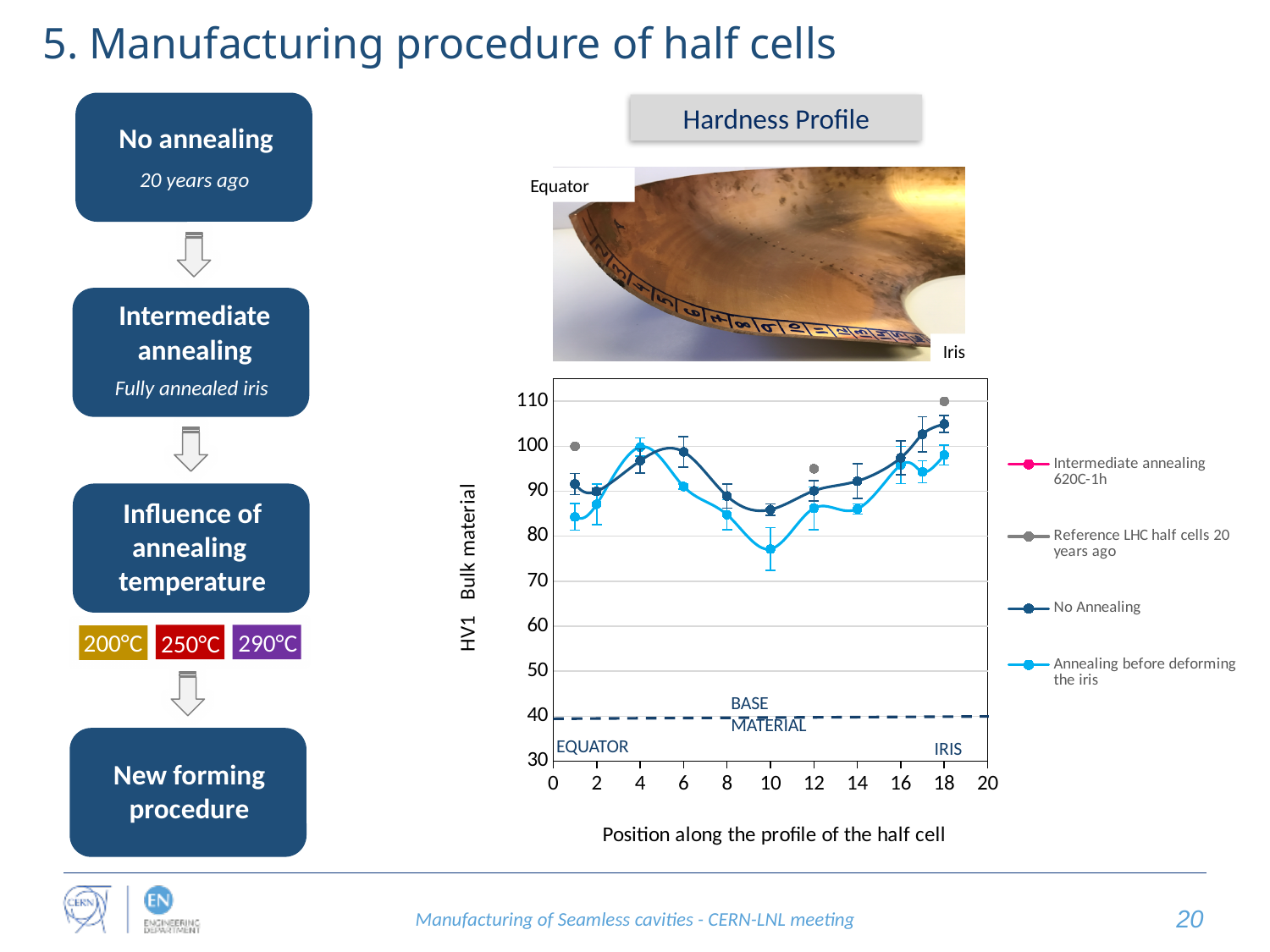
Does the 'No Annealing' series rise or fall between position 12 and position 18? rise At which position does the 'Annealing before deforming the iris' series reach its lowest value? 10 What is the title shown above the chart area? Hardness Profile At position 18, which series has the higher value: 'Reference LHC half cells 20 years ago' or 'No Annealing'? Reference LHC half cells 20 years ago Is the value of the 'Reference LHC half cells 20 years ago' series at position 12 greater or less than 90? greater How many series does the legend of the chart list? 4 Is the value of the 'Annealing before deforming the iris' series at position 10 greater or less than 80? less Is the dashed 'BASE MATERIAL' line greater or less than 50? less What is the label of the vertical axis of the chart? HV1 Bulk material At position 10, which series has the higher value: 'No Annealing' or 'Annealing before deforming the iris'? No Annealing What kind of chart is shown on the slide? line chart